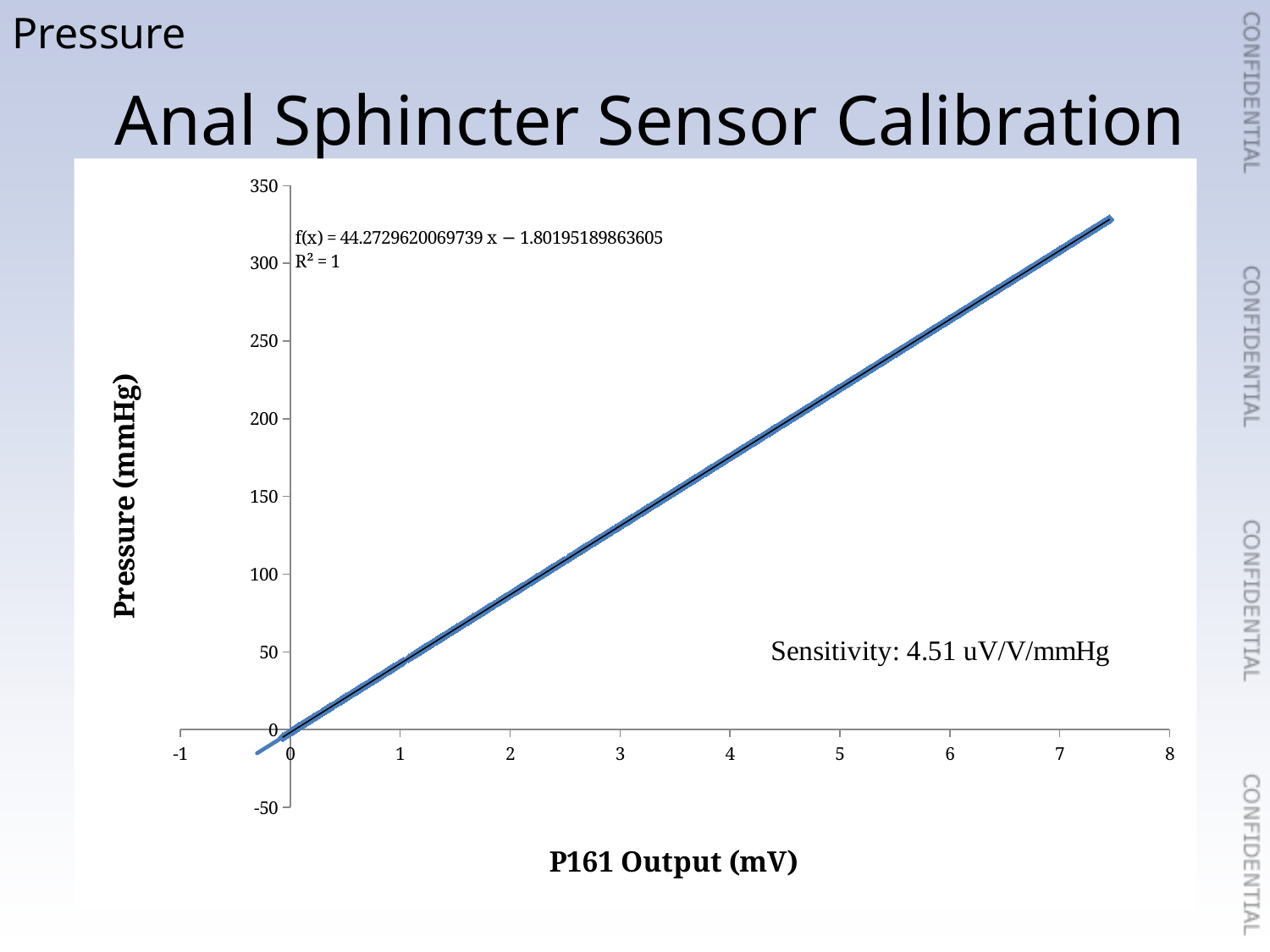
Is the pressure at a P161 output of 6 mV greater or less than 200 mmHg? greater Is the pressure at a P161 output of 7 mV greater or less than 250 mmHg? greater Does the pressure rise or fall as the P161 output increases along the x axis? Rise What R² value is shown for the fitted line on the chart? R² = 1 Is the pressure at a P161 output of 4 mV greater or less than 150 mmHg? greater What sensitivity is stated on the chart? 4.51 uV/V/mmHg What kind of chart is shown on the slide? Scatter chart with a linear trendline